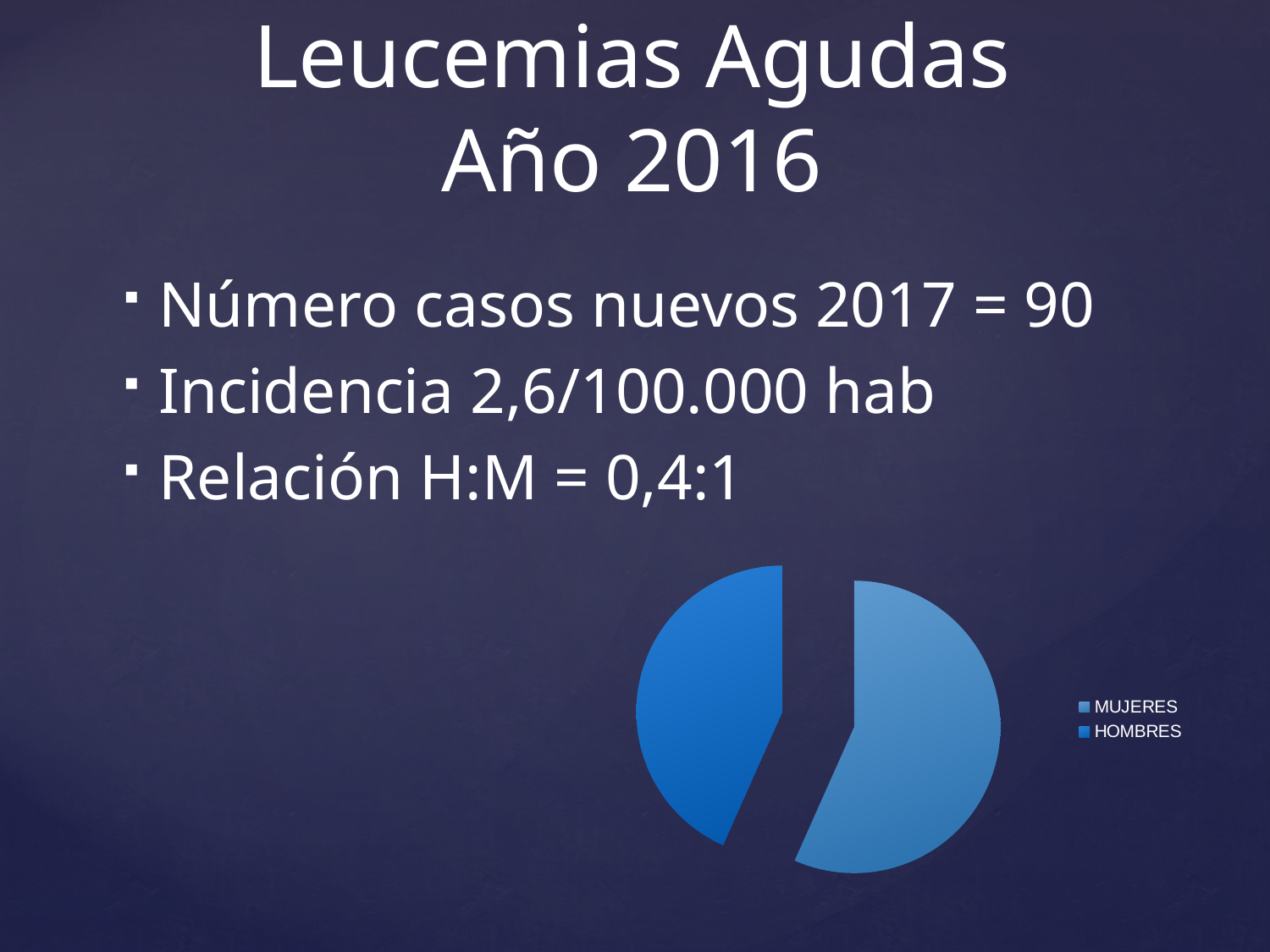
Which legend entry is listed first in the pie chart's legend? MUJERES What kind of chart is shown on the slide? Pie chart What are the two categories listed in the legend of the pie chart? MUJERES and HOMBRES Which slice is larger in the pie chart, MUJERES or HOMBRES? MUJERES How many slices does the pie chart have? 2 Which category has the smallest slice in the pie chart? HOMBRES Which category has the largest slice in the pie chart? MUJERES How many entries does the legend of the pie chart list? 2